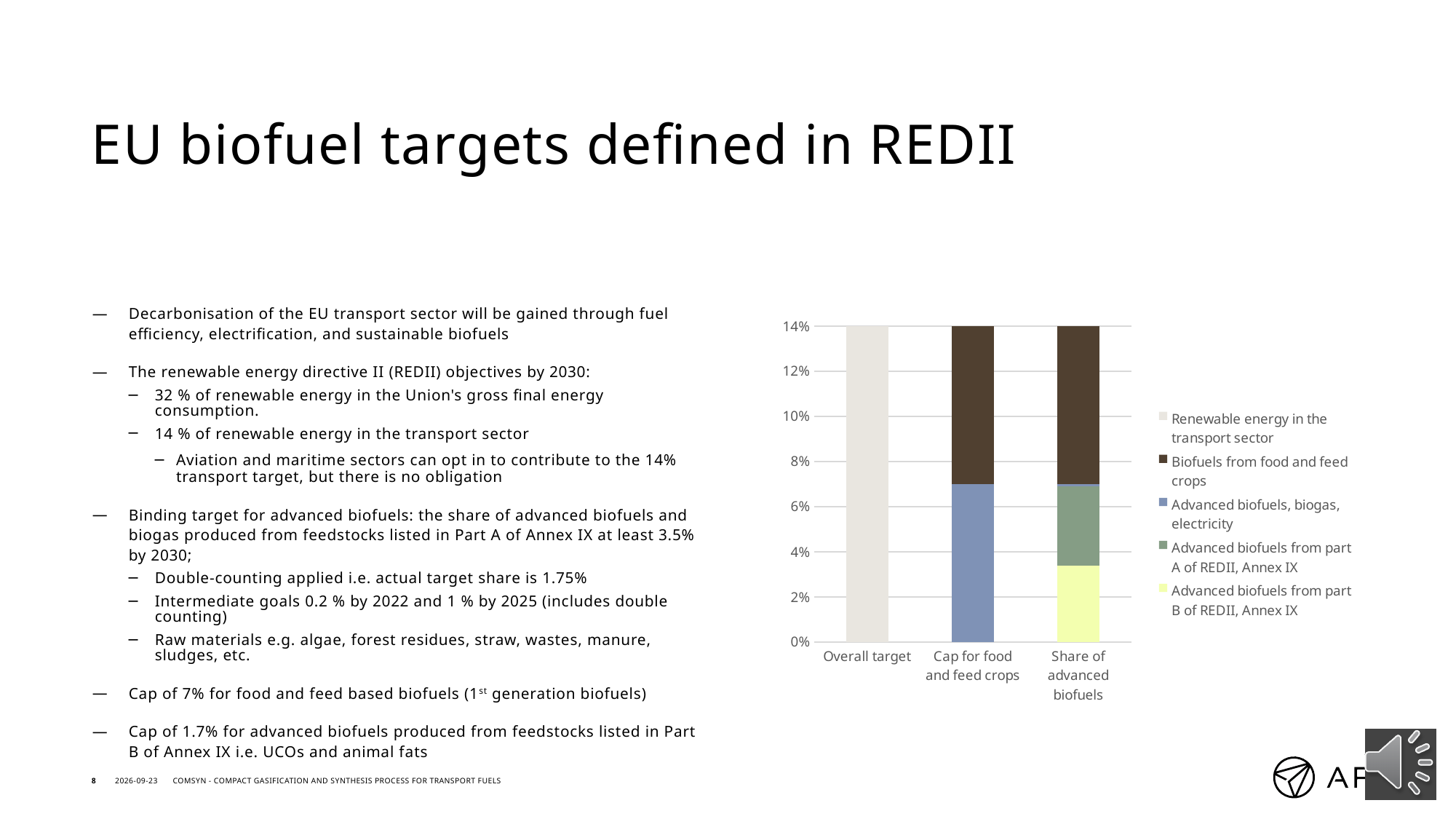
Is the 'Advanced biofuels from part B of REDII, Annex IX' segment in the 'Share of advanced biofuels' bar greater or less than 4%? less How many series does the chart's legend list? 5 What kind of chart is shown on the slide? stacked bar chart What is the total height of the stacked bar for 'Cap for food and feed crops'? 14% Which legend entry is shown in the light grey colour used for the 'Overall target' bar? Renewable energy in the transport sector Which legend entry is shown in dark brown? Biofuels from food and feed crops Is the 'Advanced biofuels, biogas, electricity' segment in the 'Cap for food and feed crops' bar greater or less than 8%? less Is the 'Advanced biofuels from part B of REDII, Annex IX' segment in the 'Share of advanced biofuels' bar greater or less than 2%? greater What is the value of the 'Overall target' bar? 14% How many categories are shown on the x axis of the chart? 3 What is the total height of the stacked bar for 'Share of advanced biofuels'? 14%